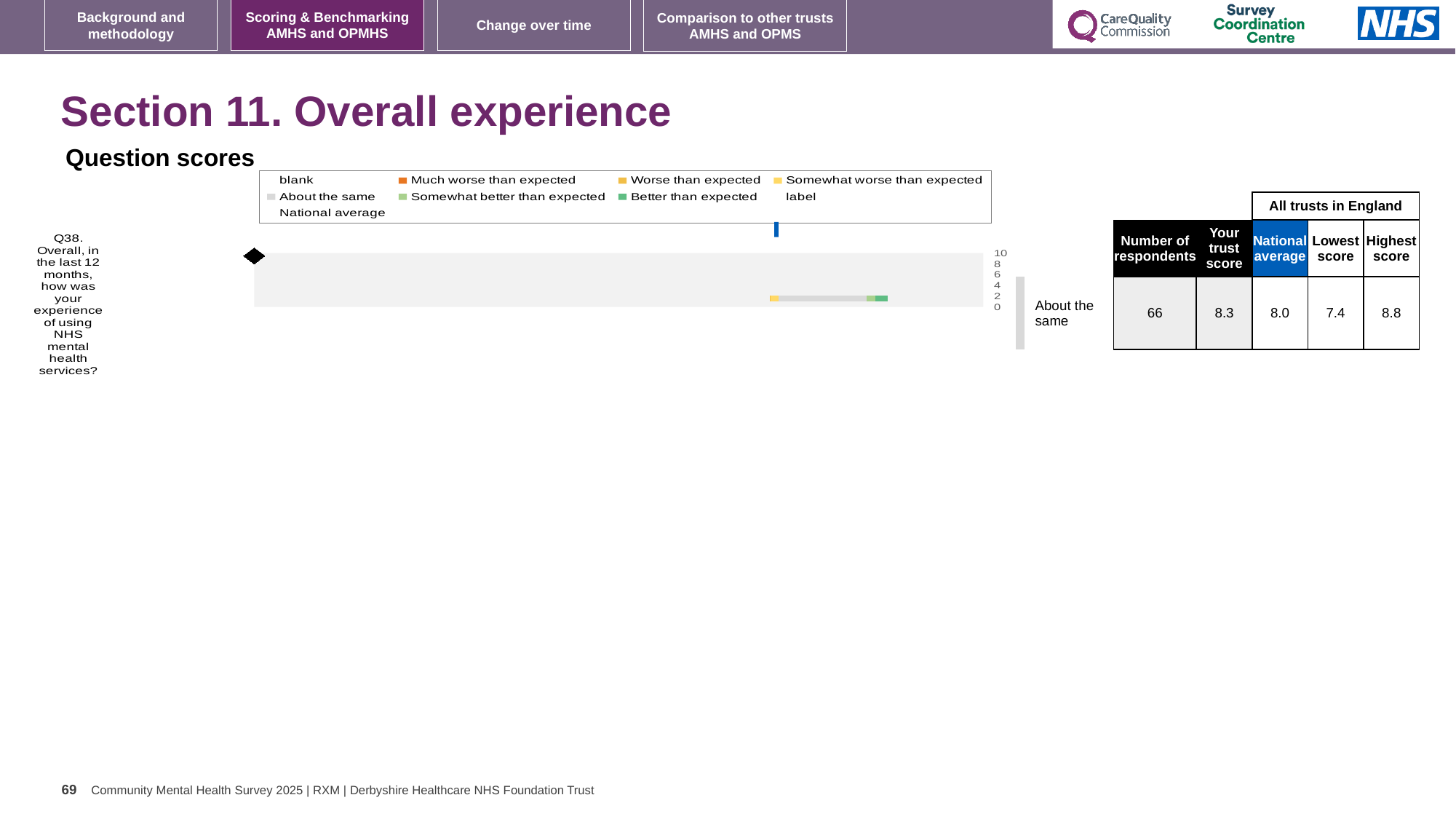
What is the highest score among all trusts in England for Q38? 8.8 How many questions are plotted in the Question scores chart? 1 What is the national average score for Q38? 8.0 What is the lowest score among all trusts in England for Q38? 7.4 What is the difference between the trust's score and the national average for Q38? 0.3 What is the difference between the highest and lowest scores among all trusts in England for Q38? 1.4 What kind of chart is shown under 'Question scores'? bar chart What is the trust's score for Q38 according to the table next to the chart? 8.3 Which benchmark category is Q38 assigned to on the slide? About the same How many respondents answered Q38? 66 What is the highest value shown on the chart's score axis? 10 Which is larger for Q38, the trust's score or the national average? the trust's score